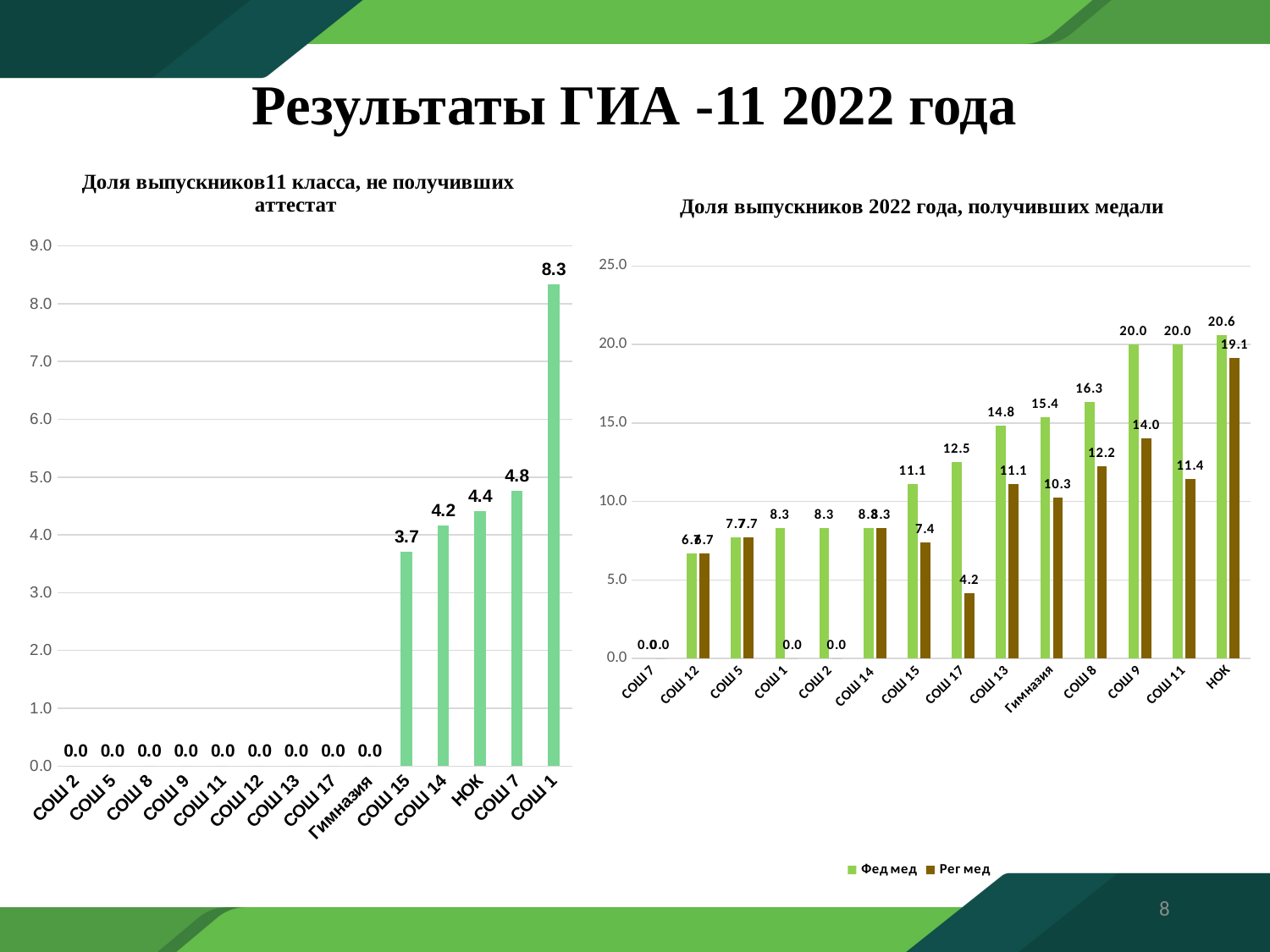
In the chart 'Доля выпускников11 класса, не получивших аттестат', what is the value for СОШ 1? 8.3 In the chart 'Доля выпускников11 класса, не получивших аттестат', what is the value for СОШ 15? 3.7 How many categories are shown on the x axis of the chart 'Доля выпускников11 класса, не получивших аттестат'? 14 In the chart 'Доля выпускников 2022 года, получивших медали', which category has the highest Рег мед value? НОК In the chart 'Доля выпускников 2022 года, получивших медали', what is the Рег мед value for СОШ 17? 4.2 In the chart 'Доля выпускников 2022 года, получивших медали', what is the Фед мед value for НОК? 20.6 In the chart 'Доля выпускников 2022 года, получивших медали', which is larger for СОШ 9: Фед мед or Рег мед? Фед мед How many series does the legend of the chart 'Доля выпускников 2022 года, получивших медали' list? 2 In the chart 'Доля выпускников11 класса, не получивших аттестат', which category has the highest value? СОШ 1 What kind of chart is 'Доля выпускников11 класса, не получивших аттестат'? Bar chart In the chart 'Доля выпускников 2022 года, получивших медали', what is the difference between the Фед мед and Рег мед values for СОШ 13? 3.7 In the chart 'Доля выпускников11 класса, не получивших аттестат', what is the difference between the values for СОШ 1 and СОШ 7? 3.5